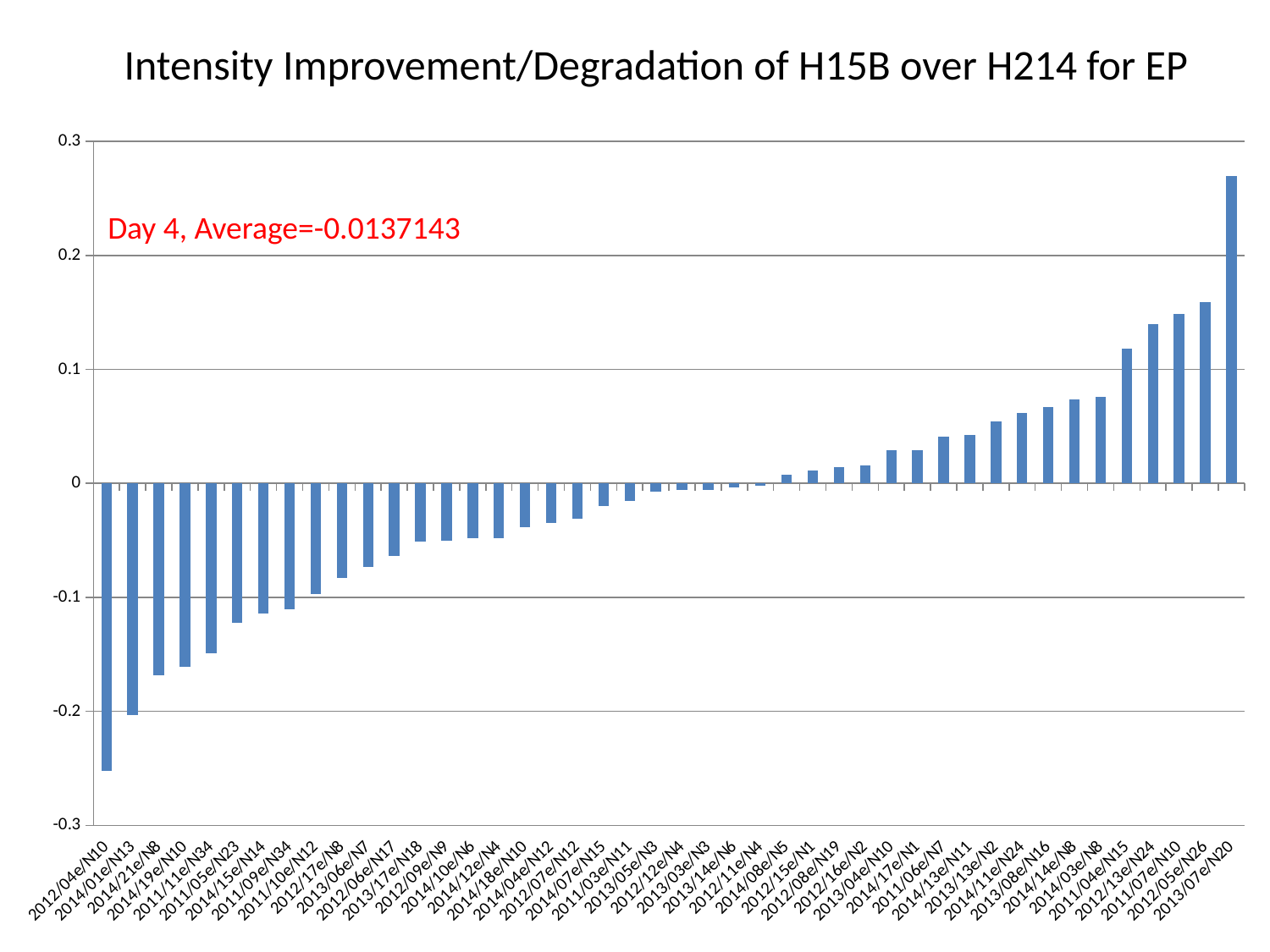
Do the values rise or fall moving from left to right along the x axis? rise Which category has the lowest value? 2012/04e/N10 What average value is stated in the red text on the chart? -0.0137143 What kind of chart is shown on the slide? bar chart Which category has the highest value? 2013/07e/N20 Is the value for 2014/21e/N8 greater or less than -0.1? less What is the title of the chart? Intensity Improvement/Degradation of H15B over H214 for EP Is the value for 2012/05e/N26 greater or less than 0.1? greater Which has the larger value, 2014/01e/N13 or 2012/04e/N10? 2014/01e/N13 Is the value for 2013/07e/N20 greater or less than 0.2? greater How many bars are plotted in the chart? 44